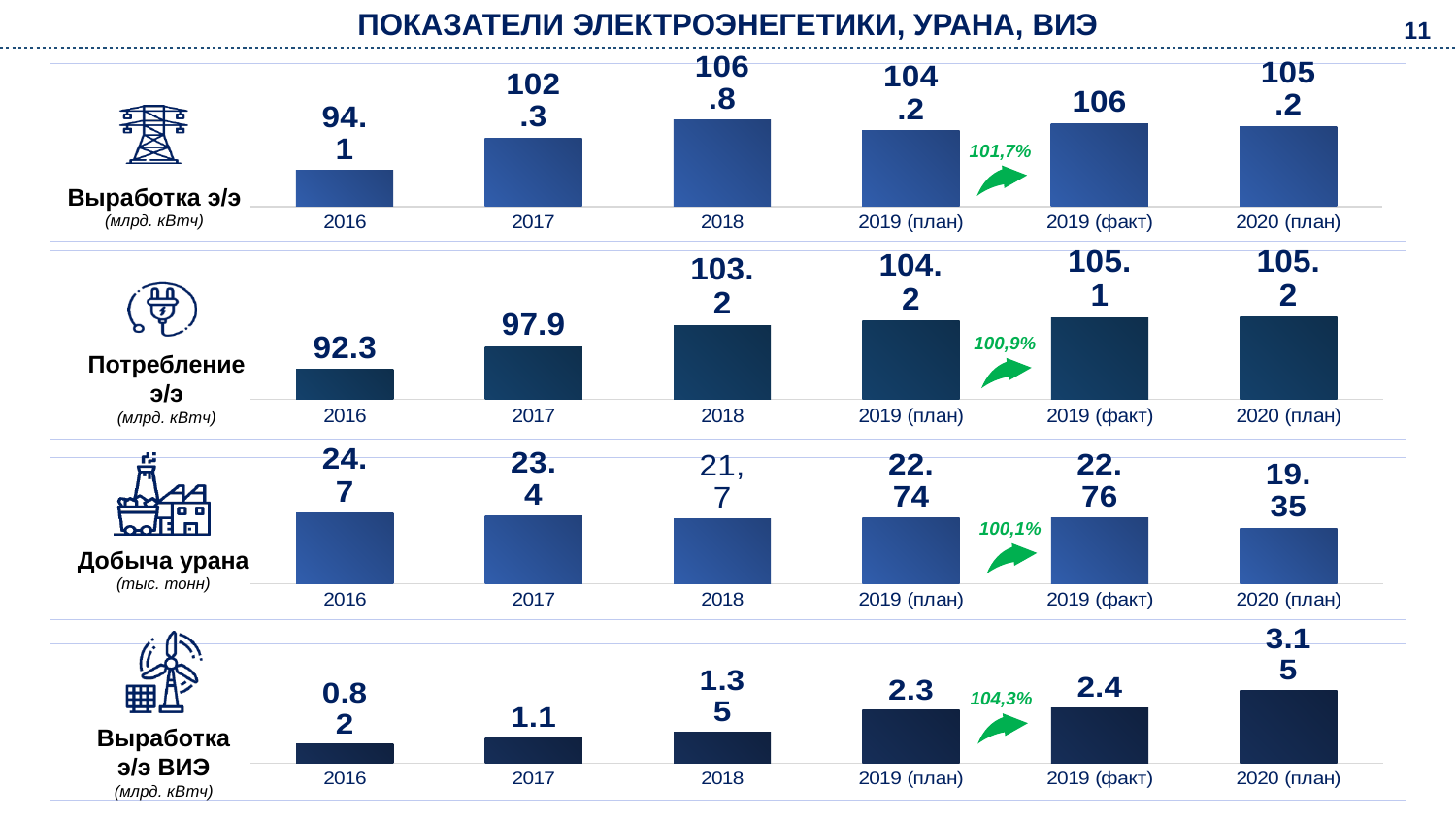
In the 'Добыча урана' chart, which is larger, the value for 2017 or the value for 2018? 2017 What type of chart is used for 'Добыча урана'? bar chart In the 'Выработка э/э' chart, what is the value for 2018? 106.8 In the 'Потребление э/э' chart, what is the difference between the 2019 (факт) and 2019 (план) values? 0.9 How many bars are in the 'Выработка э/э ВИЭ' chart? 6 In the 'Потребление э/э' chart, do the values rise or fall from 2016 to 2020 (план)? rise In the 'Добыча урана' chart, which year has the highest value? 2016 In the 'Добыча урана' chart, what is the value for 2020 (план)? 19.35 In the 'Выработка э/э ВИЭ' chart, what is the value for 2016? 0.82 In the 'Выработка э/э ВИЭ' chart, what is the difference between the 2020 (план) and 2019 (факт) values? 0.75 In the 'Выработка э/э' chart, which year has the lowest value? 2016 In the 'Потребление э/э' chart, what is the value for 2017? 97.9